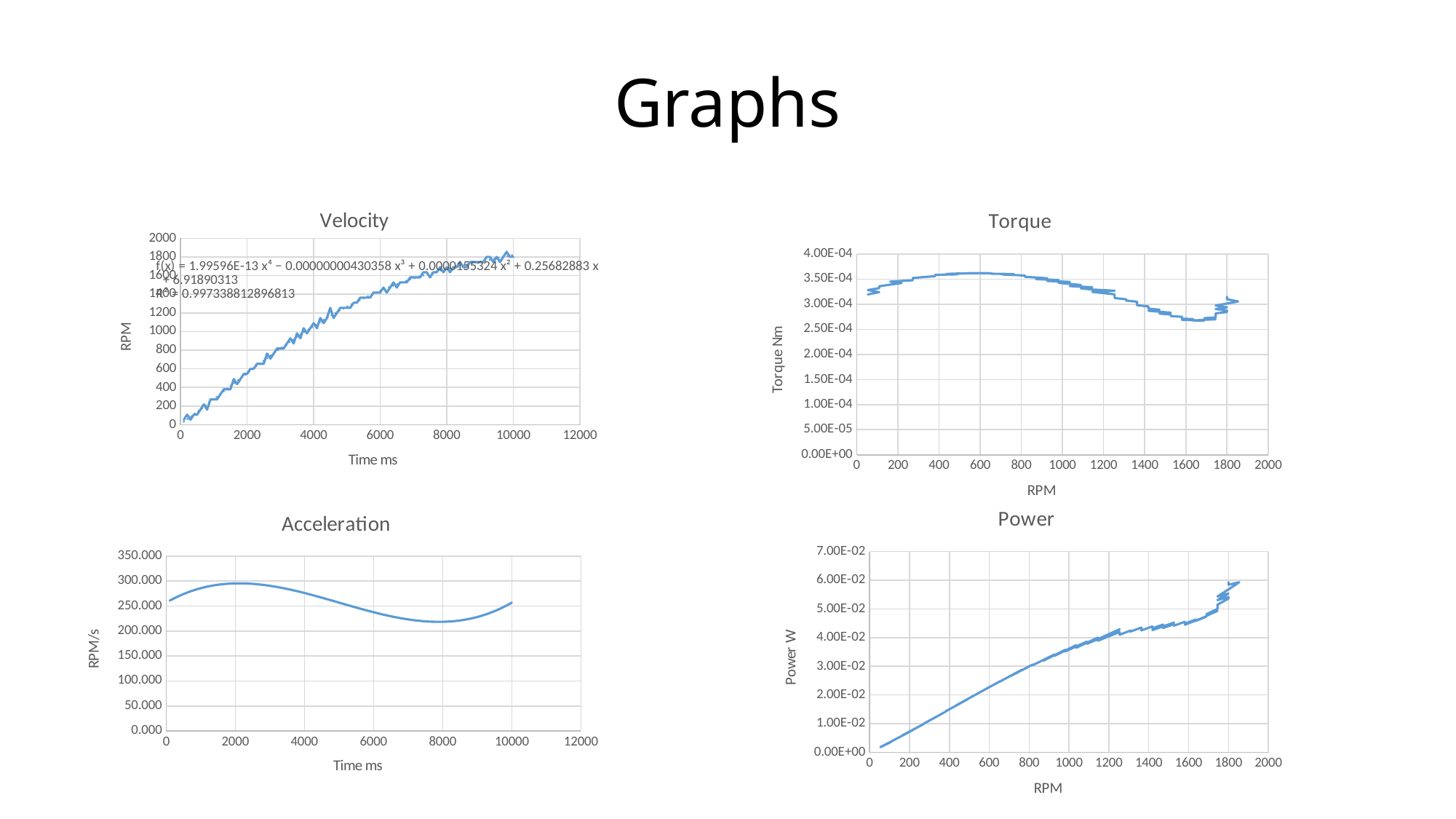
In the Torque chart, which is larger: the torque at 600 RPM or the torque at 1600 RPM? 600 RPM In the Power chart, is the power value at 1000 RPM greater or less than 4.00E-02? less In the Acceleration chart, which is larger: the value at 2000 ms or the value at 8000 ms? 2000 ms What is the x-axis title of the Velocity chart? Time ms In the Power chart, do the values rise or fall as RPM increases? rise In the Acceleration chart, is the value at 8000 ms greater or less than 250.000? less In the Torque chart, is the torque value at 1600 RPM greater or less than 3.00E-04? less In the Velocity chart, do the values rise or fall as time increases? rise What kind of chart is the Velocity chart? line chart What is the y-axis title of the Torque chart? Torque Nm